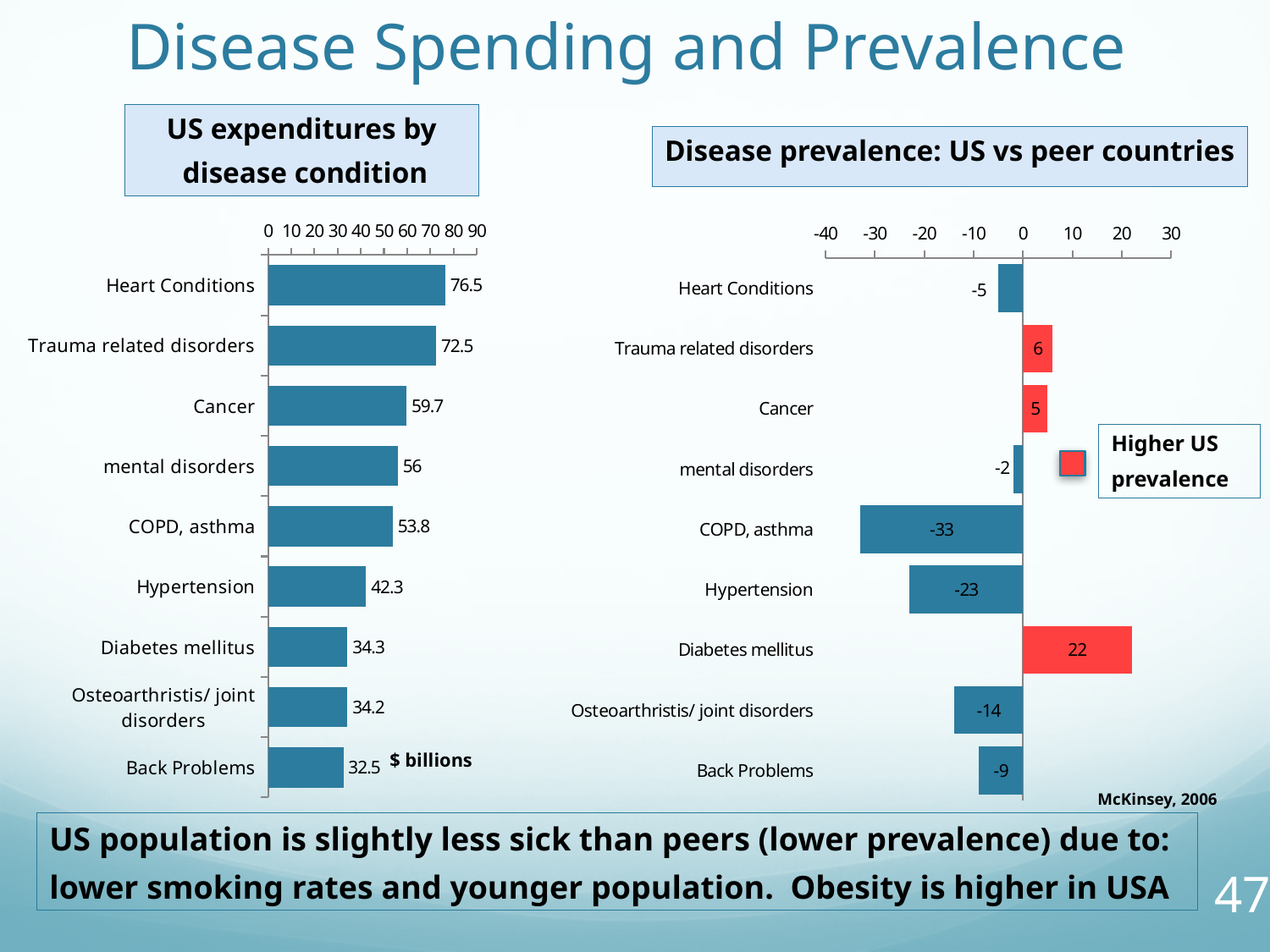
In the 'US expenditures by disease condition' chart, what is the difference between Heart Conditions and Trauma related disorders? 4 What type of chart is the 'US expenditures by disease condition' chart? bar chart In the 'US expenditures by disease condition' chart, how many categories are shown? 9 In the 'Disease prevalence: US vs peer countries' chart, is the value for Hypertension greater or less than Osteoarthristis/ joint disorders? less In the 'US expenditures by disease condition' chart, what unit is shown for the values? $ billions In the 'US expenditures by disease condition' chart, which category has the lowest value? Back Problems In the 'US expenditures by disease condition' chart, what is the value for Cancer? 59.7 In the 'Disease prevalence: US vs peer countries' chart, what is the value for COPD, asthma? -33 In the 'Disease prevalence: US vs peer countries' chart, what do the red bars indicate? Higher US prevalence In the 'Disease prevalence: US vs peer countries' chart, which category has the lowest value? COPD, asthma In the 'Disease prevalence: US vs peer countries' chart, what is the value for Diabetes mellitus? 22 In the 'US expenditures by disease condition' chart, which category has the highest value? Heart Conditions